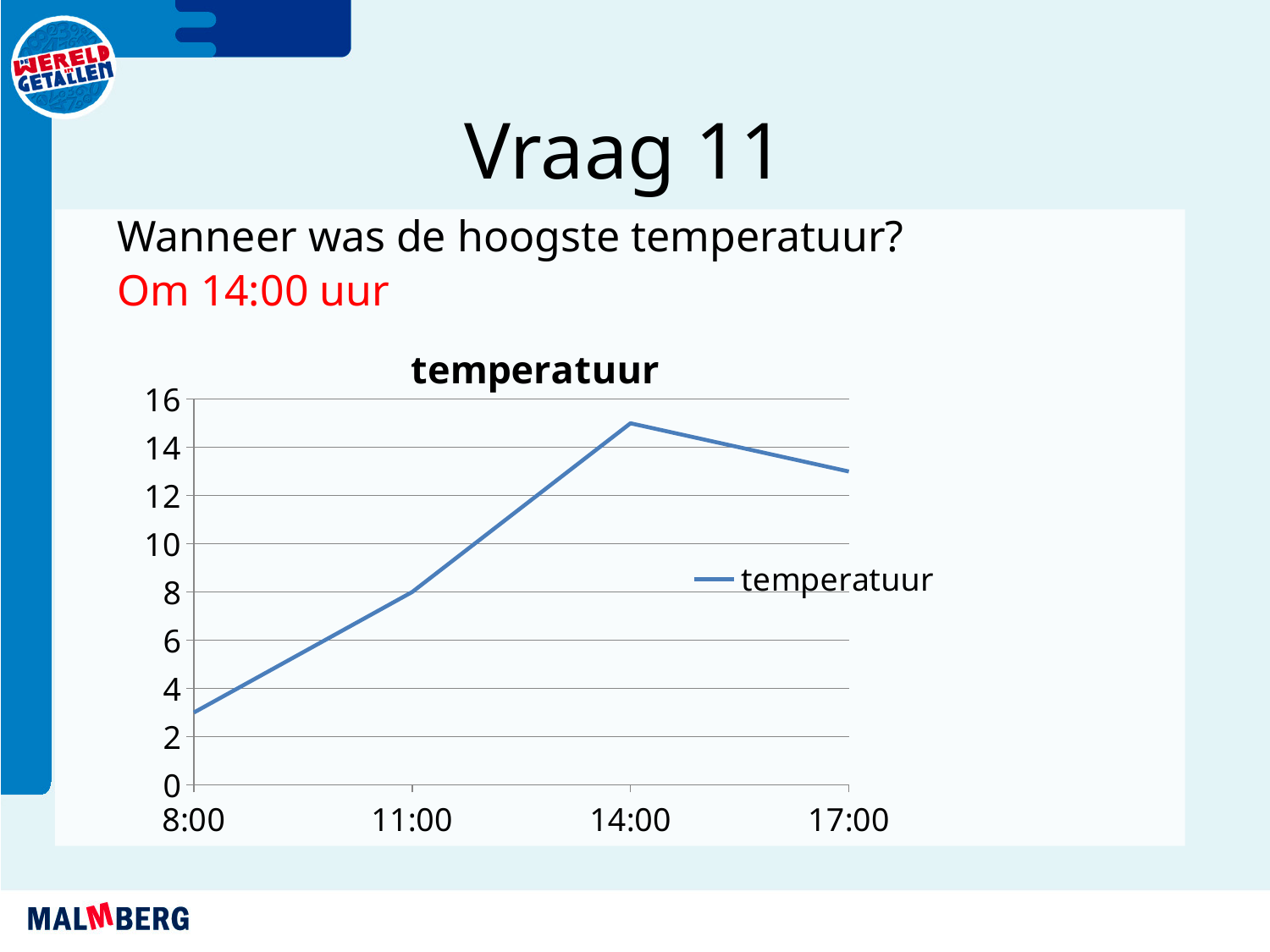
Is the value at 8:00 greater or less than 4? less At which time is the temperature highest? 14:00 Which is larger, the temperature at 11:00 or at 17:00? 17:00 How many time points are plotted on the x axis? 4 What is the temperature at 11:00? 8 Is the value at 14:00 greater or less than 14? greater What kind of chart is shown on the slide? line chart How many series does the legend list? 1 At which time is the temperature lowest? 8:00 Is the value at 17:00 greater or less than 12? greater Does the temperature rise or fall between 8:00 and 14:00? rise What is the title of the chart? temperatuur